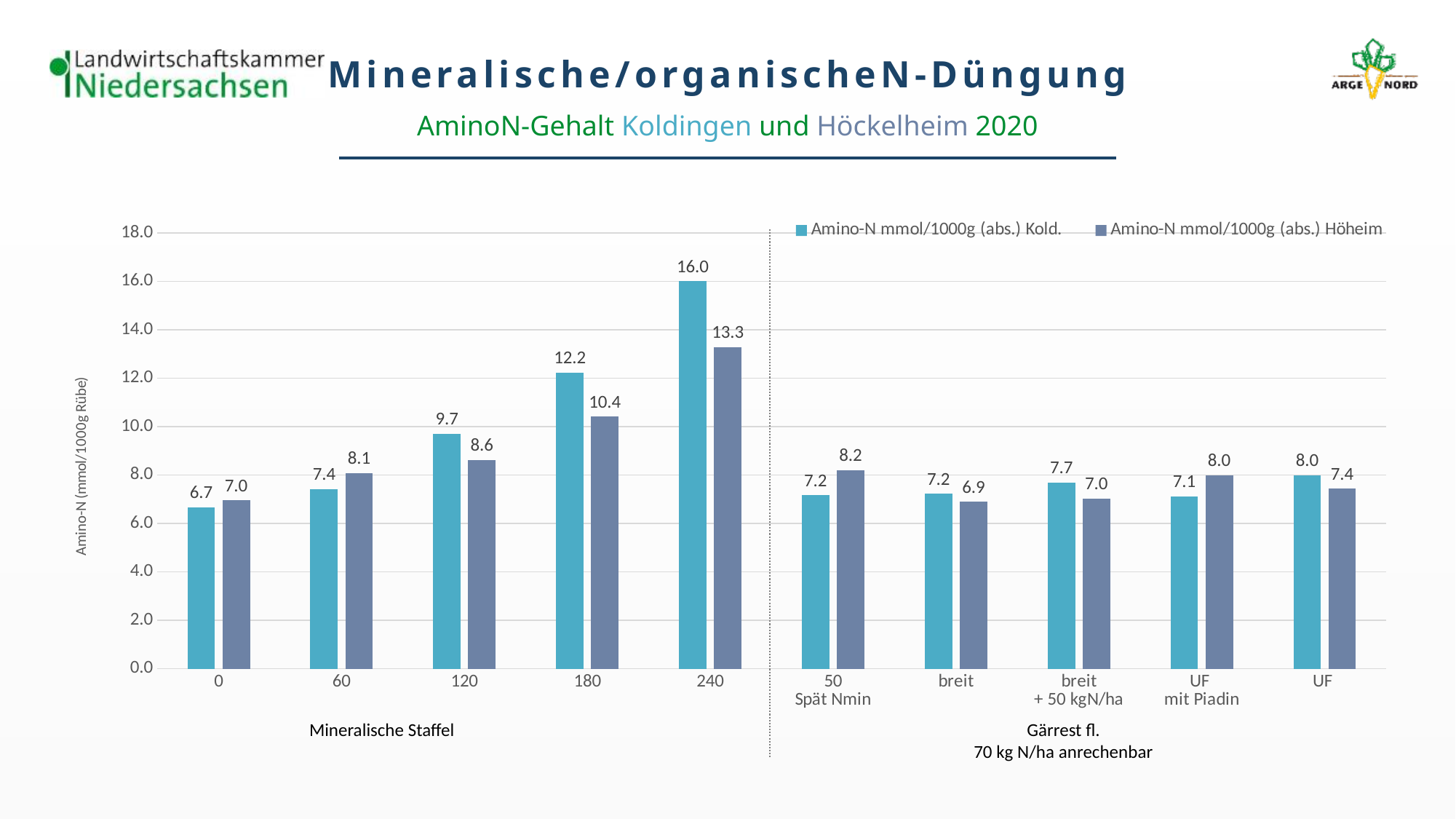
How many series does the chart legend list? 2 Is the Koldingen (Kold.) value at the 180 category greater or less than 10.0? greater What is the Amino-N value for Koldingen (Kold.) at the 240 category? 16.0 Across the 'Mineralische Staffel' categories from 0 to 240, do the Koldingen (Kold.) values rise or fall? rise Which category has the highest Amino-N value for the Koldingen (Kold.) series? 240 What is the Amino-N value for Koldingen (Kold.) at the 'UF mit Piadin' category? 7.1 What is the difference between the Koldingen (Kold.) and Höckelheim (Höheim) values at the 240 category? 2.7 What kind of chart is shown on the slide? bar chart What is the Amino-N value for Höckelheim (Höheim) at the 180 category? 10.4 How many categories are shown on the x axis of the chart? 10 Which category has the lowest Amino-N value for the Höckelheim (Höheim) series? breit At the '50 Spät Nmin' category, which series has the larger value, Koldingen (Kold.) or Höckelheim (Höheim)? Höckelheim (Höheim)